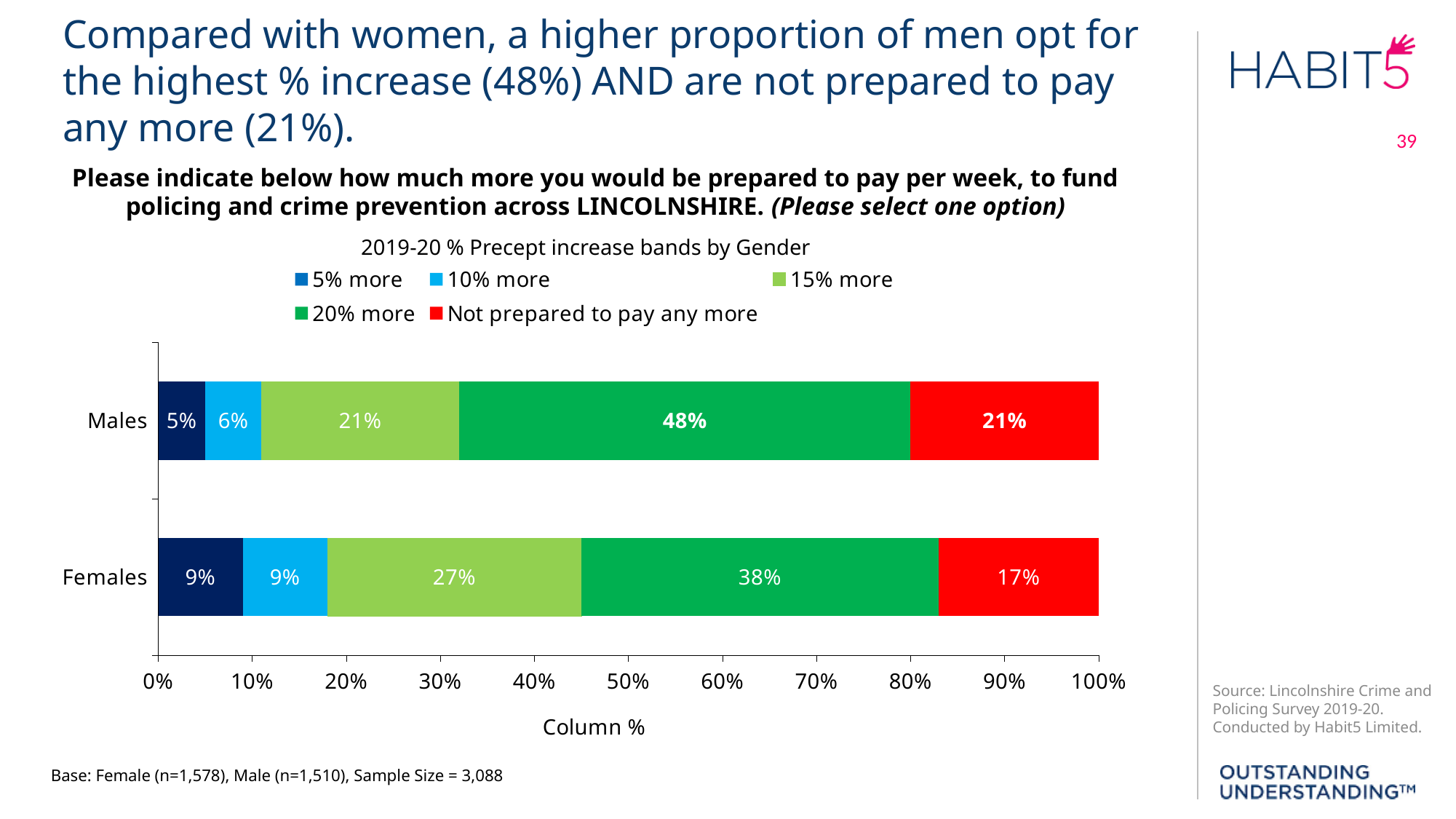
What is the difference between the Males and Females percentages for '20% more'? 10% Which response band has the smallest share among Males? 5% more What type of chart is shown? Stacked bar chart What is the title of the chart? 2019-20 % Precept increase bands by Gender What percentage of Males are 'Not prepared to pay any more'? 21% What percentage of Females chose '5% more'? 9% Which gender has a higher percentage for '15% more'? Females What percentage of Males chose '20% more'? 48% What percentage of Females chose '15% more'? 27% How many gender categories are shown on the chart? 2 How many series does the legend list? 5 Which response band has the largest share among Females? 20% more